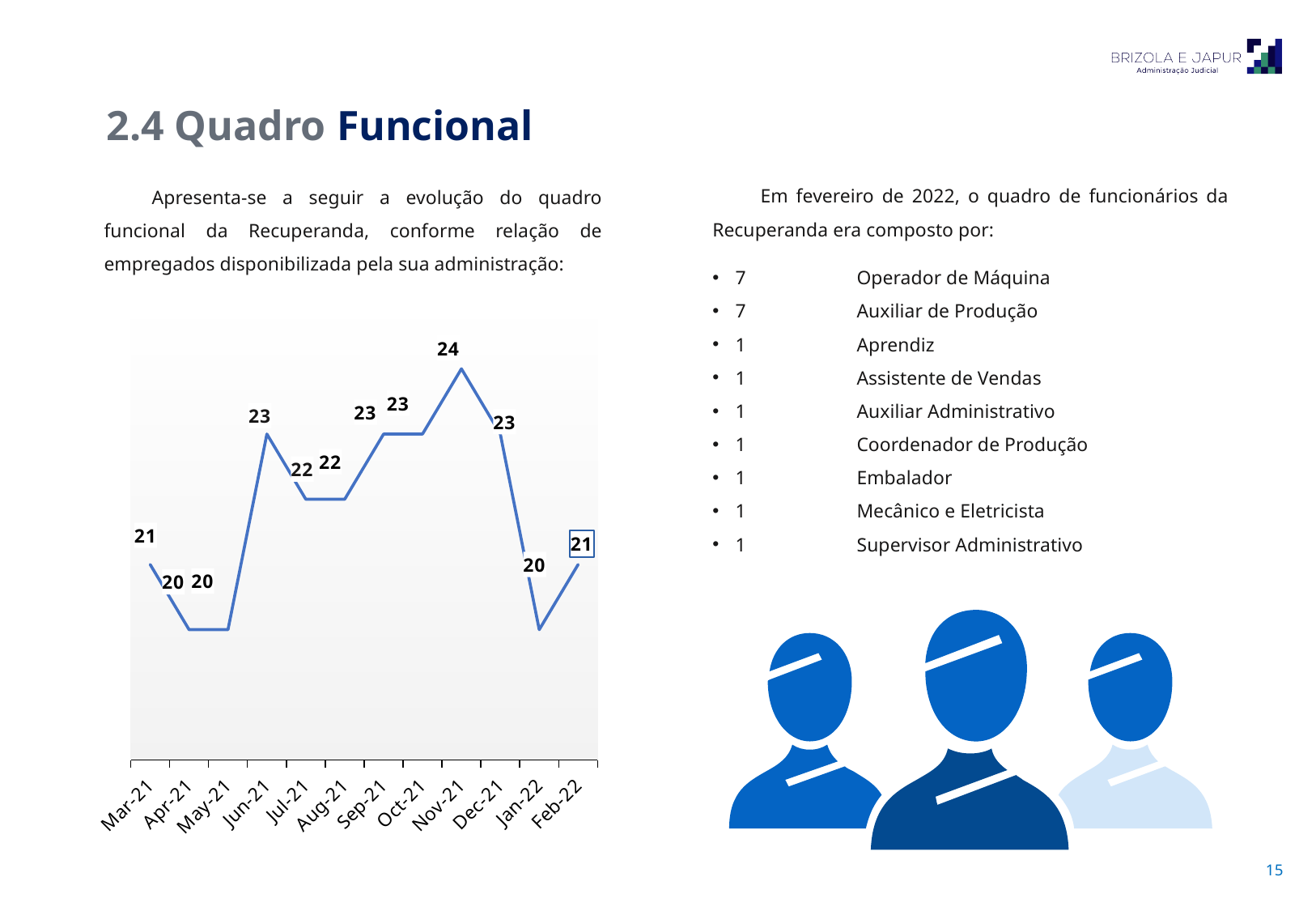
Which is larger, the value for Jun-21 or the value for Apr-21? Jun-21 What is the value for Nov-21 on the line chart? 24 What is the first month shown on the x axis of the line chart? Mar-21 What is the difference between the values for Nov-21 and Jan-22? 4 How many data points are plotted on the line chart? 12 What type of chart is shown on the slide? line chart Which month has the highest value on the line chart? Nov-21 What is the value for Mar-21 on the line chart? 21 What is the value for Feb-22 on the line chart? 21 What is the value for Jan-22 on the line chart? 20 Does the value rise or fall from Nov-21 to Jan-22? fall What is the difference between the values for Jun-21 and Jul-21? 1